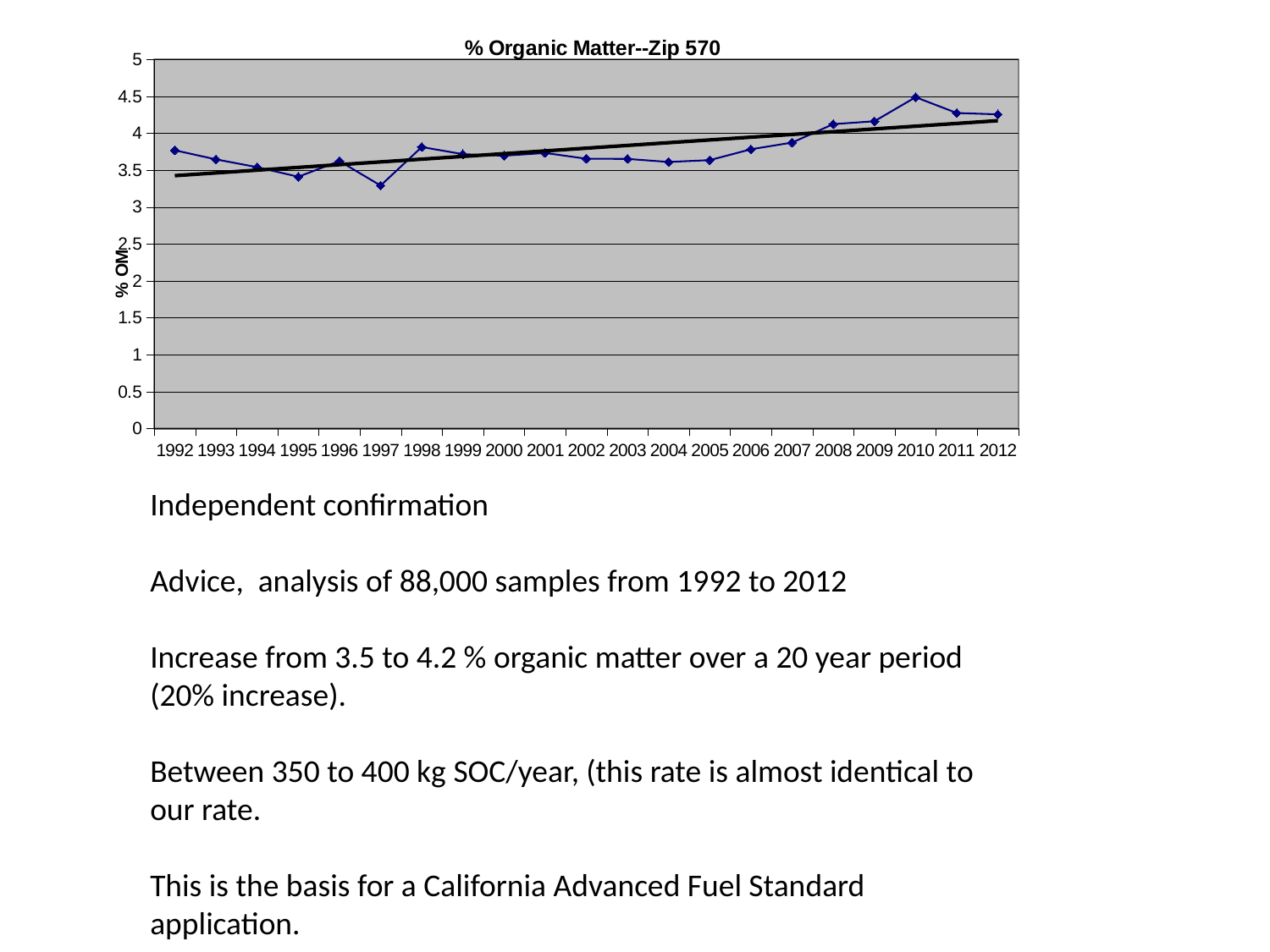
Which year has the larger value, 1992 or 1997? 1992 Which year has the larger value, 1997 or 2010? 2010 Do the % organic matter values generally rise or fall from 1992 to 2012? rise Is the value for 1997 greater or less than 3.5? less What kind of chart is shown on the slide? line chart Is the value for 2010 greater or less than 4? greater How many years are plotted along the x axis of the chart? 21 Is the value for 2012 greater or less than 4? greater Which year has the highest % organic matter value? 2010 What is the title of the chart? % Organic Matter--Zip 570 Which year has the lowest % organic matter value? 1997 What is the label on the vertical axis of the chart? % OM